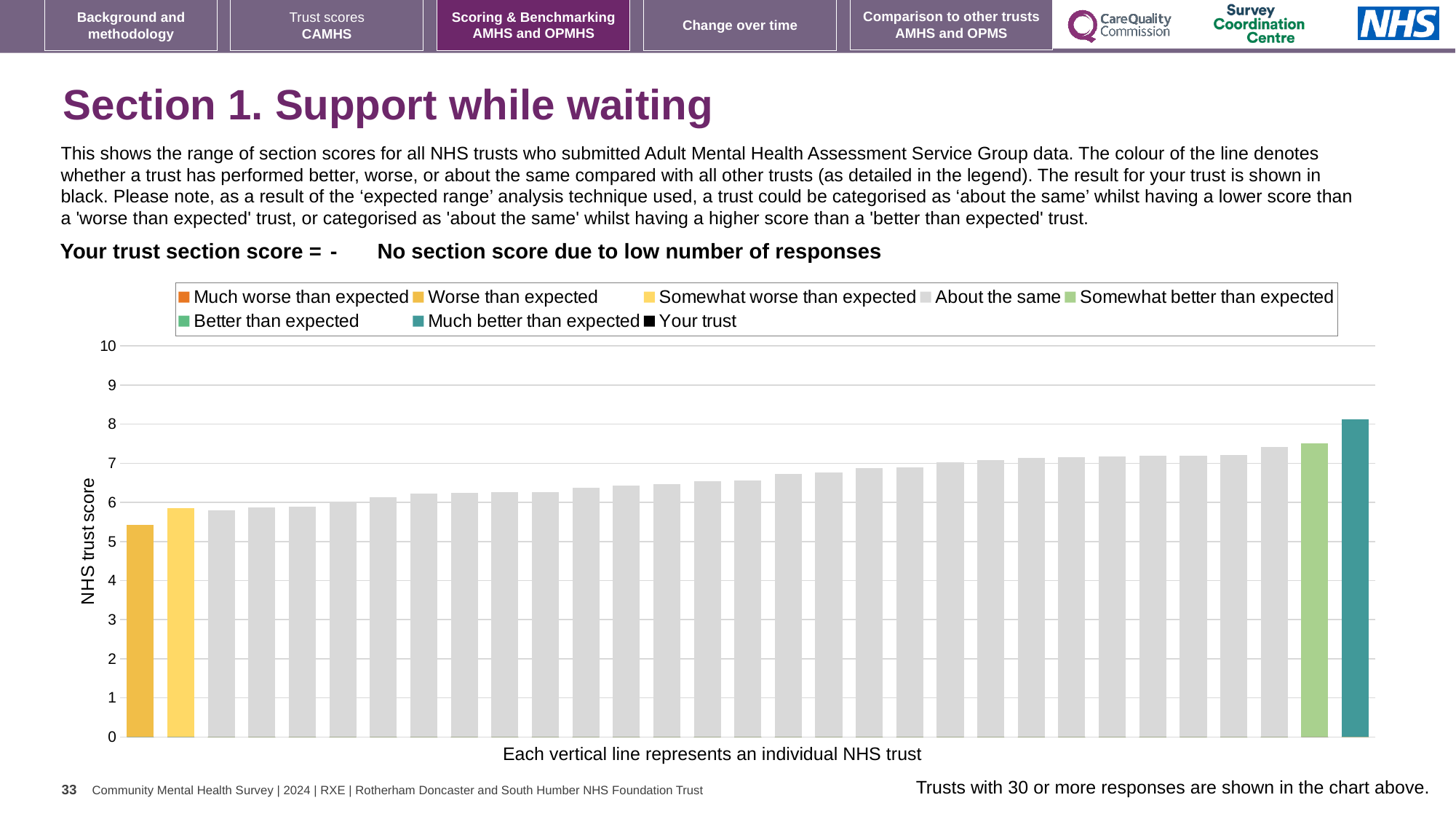
What is the highest tick value shown on the vertical axis? 10 How many entries does the chart legend list? 8 Which bar is the lowest in the chart? The leftmost bar Is the value of the tallest bar greater or less than 7? greater What is the label on the vertical axis of the chart? NHS trust score What kind of chart is shown on the slide? Bar chart How many bars (NHS trusts) are plotted in the chart? 31 Is the value of the shortest bar greater or less than 6? less Which is larger, the value of the rightmost bar or the value of the leftmost bar? The rightmost bar Which bar is the highest in the chart? The rightmost bar Is the value of the shortest bar greater or less than 5? greater Do the bar values rise or fall from left to right across the chart? Rise